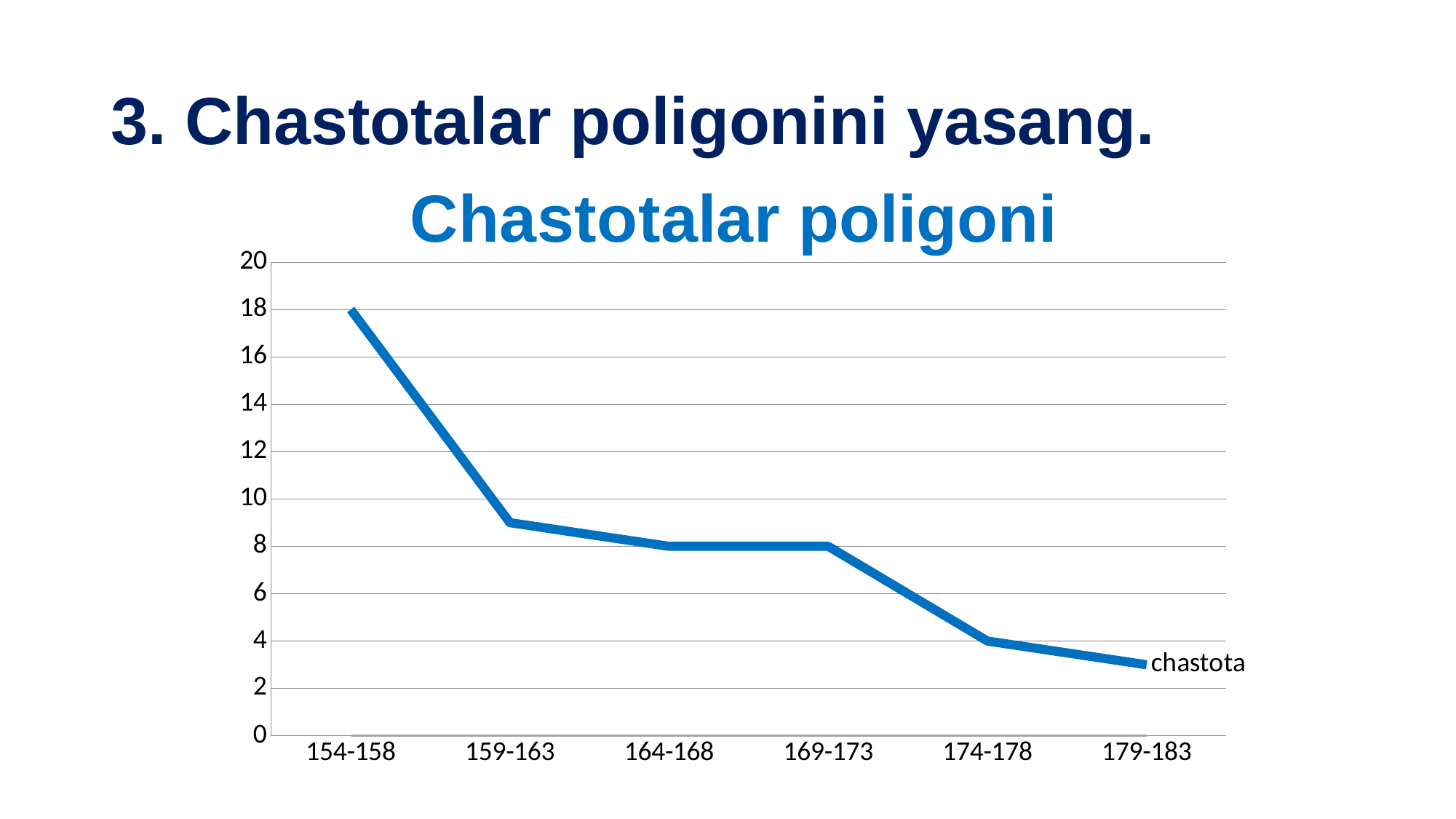
How many categories are shown on the x axis? 6 What is the name of the series plotted on the chart? chastota What is the title of the chart? Chastotalar poligoni What is the value for 164-168? 8 What is the value for 174-178? 4 Which category has the lowest value? 179-183 What type of chart is shown on the slide? Line chart Do the values rise or fall from left to right along the x axis? Fall Is the value for 159-163 greater or less than 10? less Which category has the highest value? 154-158 What is the value for 154-158? 18 How many series does the chart plot? 1